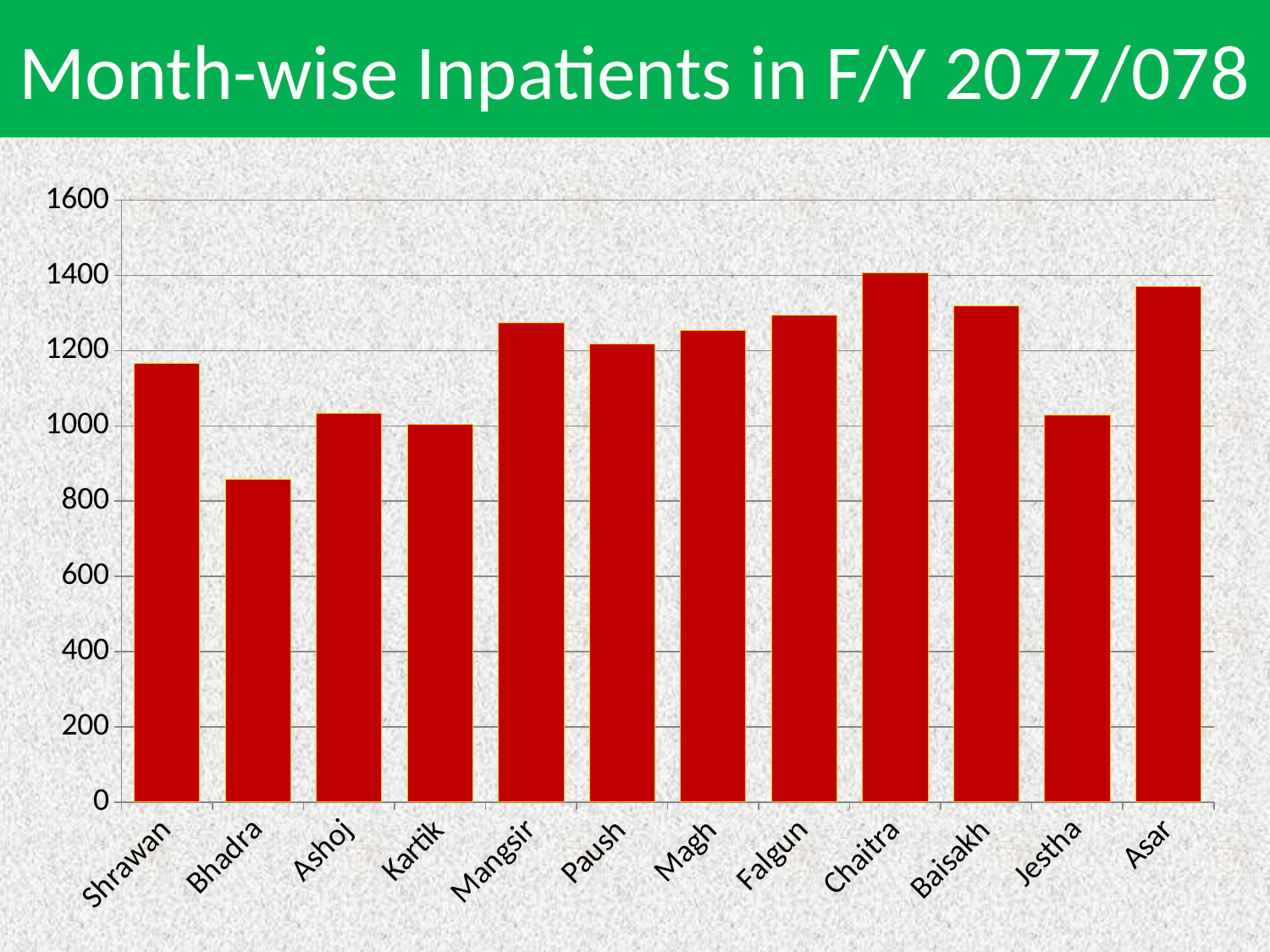
Is the value for Mangsir greater or less than 1200? greater How many months are shown on the x axis of the chart? 12 Is the value for Asar greater or less than 1200? greater Is the value for Bhadra greater or less than 1000? less Which month has the highest number of inpatients? Chaitra Which month has more inpatients, Chaitra or Jestha? Chaitra Which month has more inpatients, Mangsir or Paush? Mangsir Which month has more inpatients, Shrawan or Bhadra? Shrawan Which month has the lowest number of inpatients? Bhadra What type of chart is shown on the slide? Bar chart What is the title of the chart? Month-wise Inpatients in F/Y 2077/078